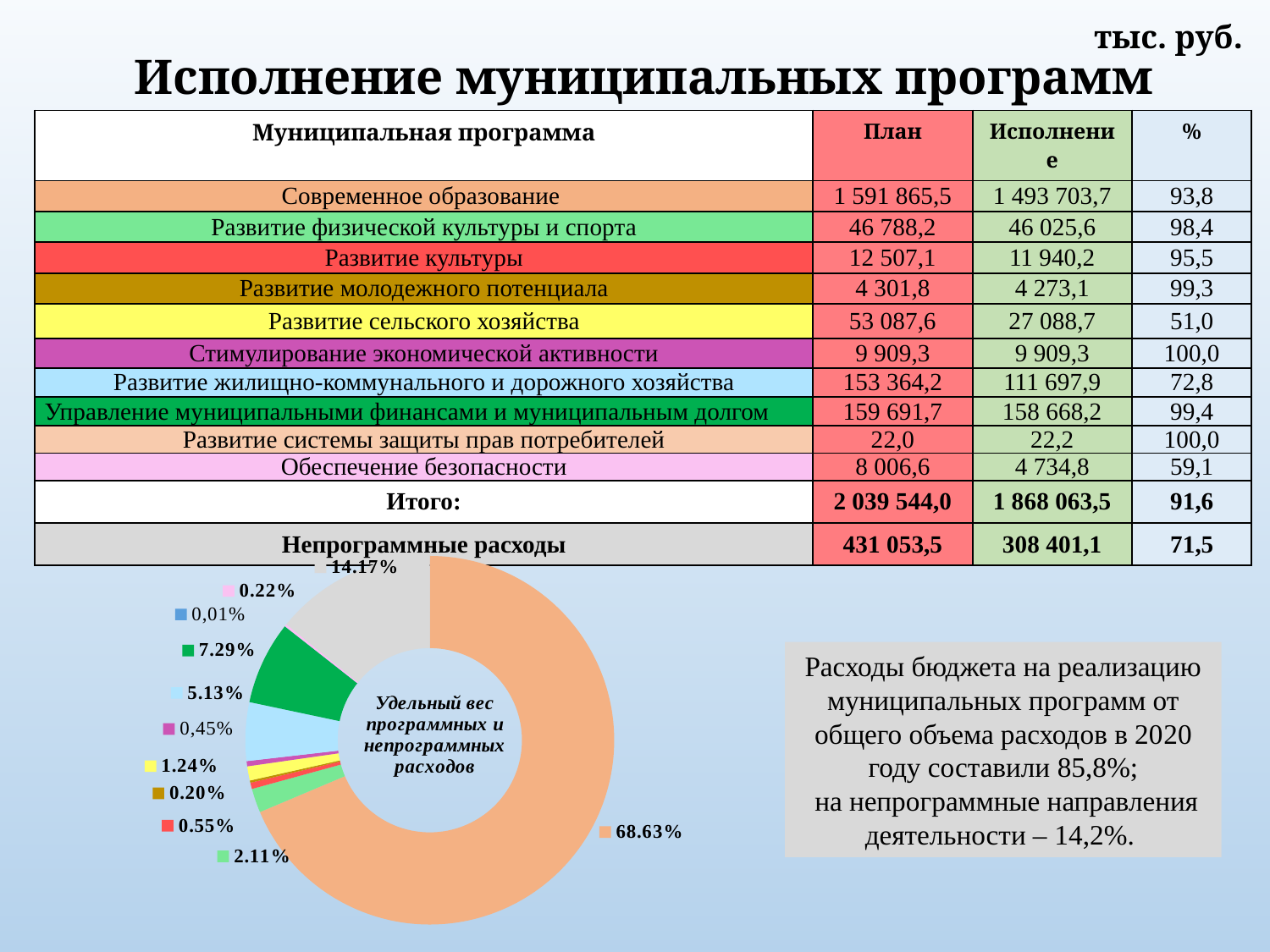
Which is larger in the doughnut chart: the slice labelled 7.29% or the slice labelled 5.13%? 7.29% What is the value of the dark green slice in the doughnut chart? 7.29% What is the title shown in the centre of the doughnut chart? Удельный вес программных и непрограммных расходов What is the value of the largest slice in the doughnut chart? 68.63% What is the value of the orange slice in the doughnut chart? 68.63% How many slices (data labels) does the doughnut chart show? 11 What kind of chart is shown on the slide? doughnut (pie) chart Is the largest slice of the doughnut chart greater or less than 50%? greater What is the value of the light blue slice in the doughnut chart? 5.13% What is the value of the grey slice in the doughnut chart? 14.17% What is the value of the smallest slice in the doughnut chart? 0,01% What is the difference between the largest slice (68.63%) and the second largest slice (14.17%) in the doughnut chart? 54.46%